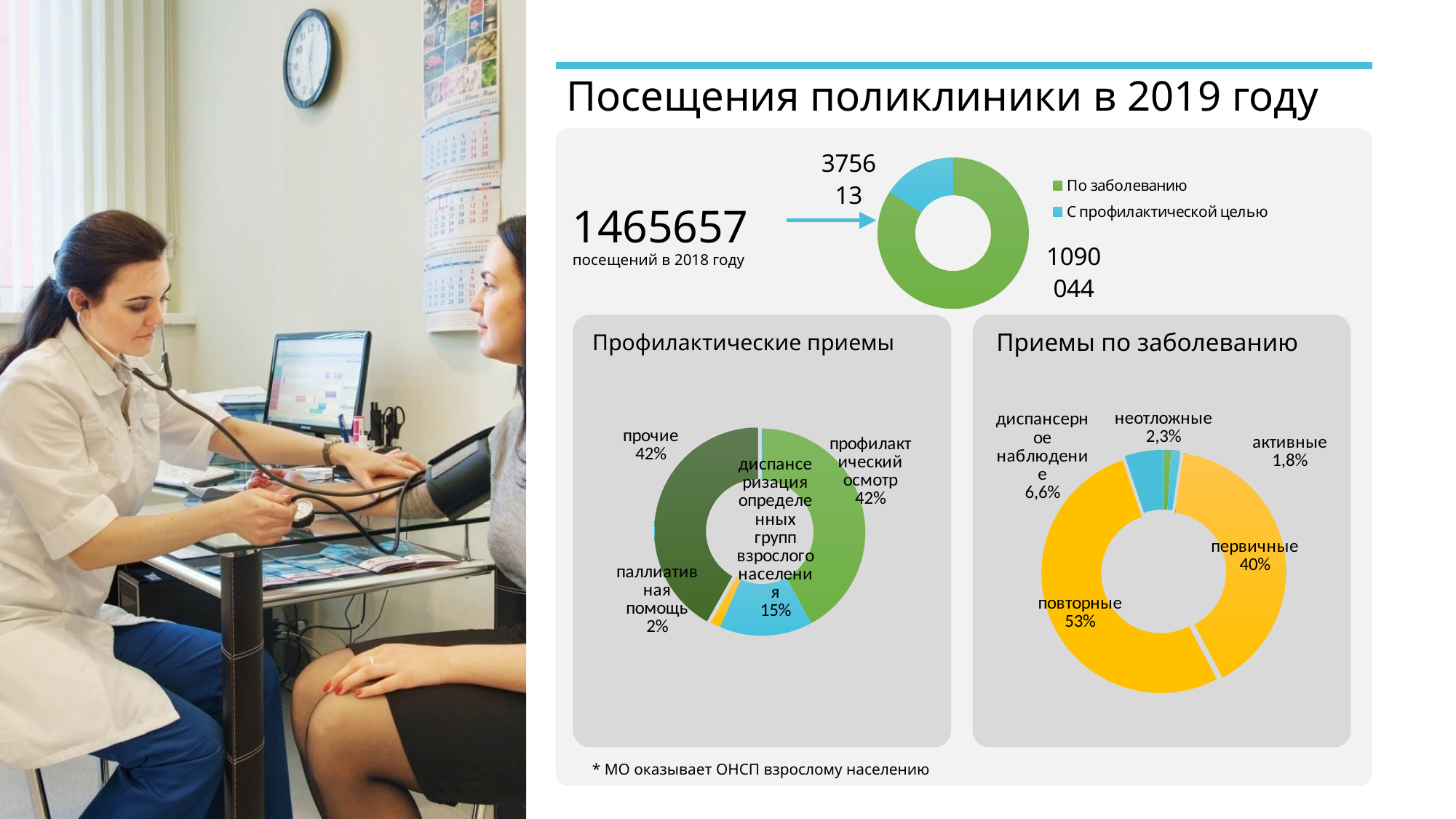
In the "Профилактические приемы" chart, what share is "паллиативная помощь"? 2% In the "Приемы по заболеванию" chart, what share is "диспансерное наблюдение"? 6,6% In the top chart, what is the value for "По заболеванию"? 1090044 In the top chart, what is the value for "С профилактической целью"? 375613 In the top chart, how many entries does the legend list? 2 In the "Приемы по заболеванию" chart, which category has the smallest share? активные In the top chart, which segment is larger: "По заболеванию" or "С профилактической целью"? По заболеванию In the "Приемы по заболеванию" chart, what is the difference between "повторные" and "первичные"? 13% In the "Приемы по заболеванию" chart, which category has the largest share? повторные In the "Профилактические приемы" chart, how many slices are there? 4 In the "Профилактические приемы" chart, what share is "диспансеризация определенных групп взрослого населения"? 15% What kind of chart is used for "Приемы по заболеванию"? Donut (pie) chart